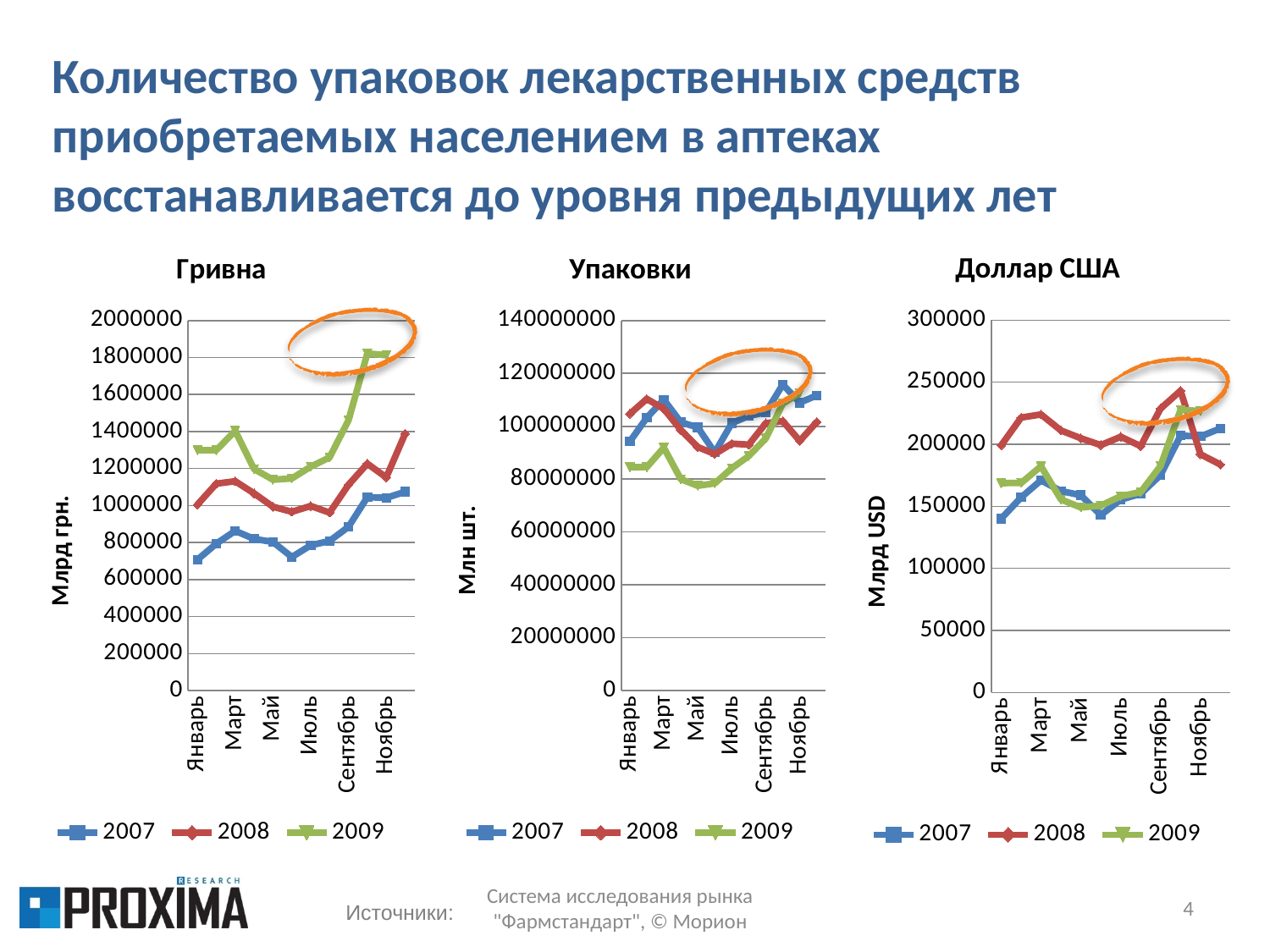
What is the y-axis label of the "Упаковки" chart? Млн шт. In the "Упаковки" chart, is the value for 2007 in Сентябрь greater or less than 100000000? greater In the "Упаковки" chart, which series has the larger value in Январь, 2007 or 2009? 2007 In the "Доллар США" chart, is the value for 2008 in Сентябрь greater or less than 200000? greater In the "Гривна" chart, is the value for 2009 in Май greater or less than 1000000? greater How many series does the legend of the "Упаковки" chart list? 3 In the "Доллар США" chart, which years are listed in the legend? 2007, 2008, 2009 In the "Гривна" chart, does the 2009 series rise or fall from Июль to its last point? rise What kind of chart is the chart titled "Гривна"? line chart